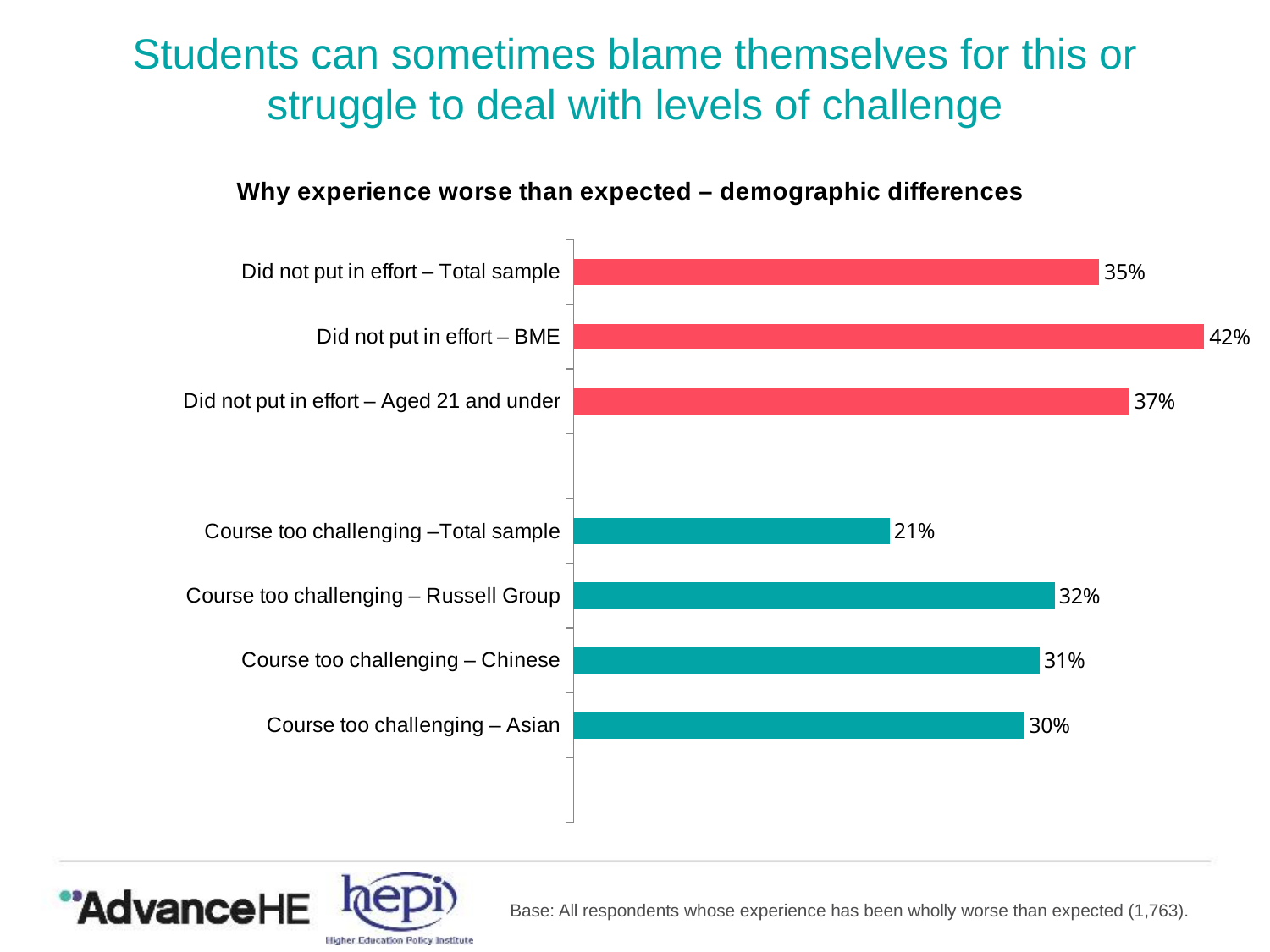
How many bars are shown in the chart? 7 What kind of chart is shown on the slide? Bar chart What is the title of the chart? Why experience worse than expected – demographic differences What is the value for "Course too challenging – Russell Group"? 32% What is the value for "Did not put in effort – BME"? 42% What is the difference between "Course too challenging – Russell Group" and "Course too challenging – Total sample"? 11% What is the difference between "Did not put in effort – BME" and "Did not put in effort – Total sample"? 7% Which is larger: "Course too challenging – Chinese" or "Course too challenging – Asian"? Course too challenging – Chinese What is the value for "Did not put in effort – Aged 21 and under"? 37% Which category has the highest value? Did not put in effort – BME Which category has the lowest value? Course too challenging – Total sample What is the value for "Course too challenging – Total sample"? 21%